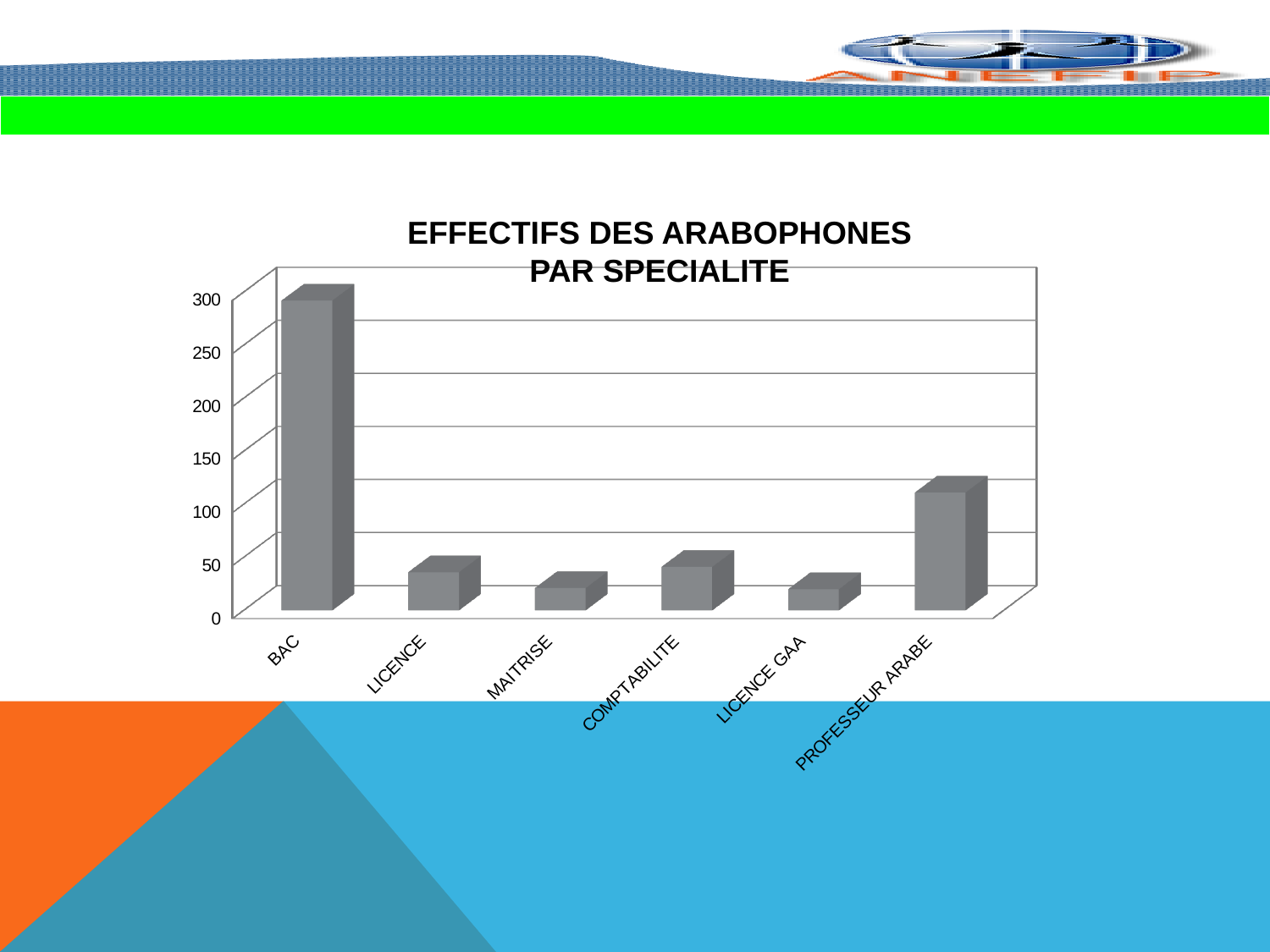
Is the value for BAC greater or less than 250? greater What is the title of the chart? EFFECTIFS DES ARABOPHONES PAR SPECIALITE Which has a larger value, PROFESSEUR ARABE or LICENCE? PROFESSEUR ARABE How many categories are shown on the x axis of the chart? 6 Is the value for PROFESSEUR ARABE greater or less than 50? greater What type of chart is shown on the slide? bar chart Is the value for PROFESSEUR ARABE greater or less than 150? less Which has a larger value, BAC or PROFESSEUR ARABE? BAC Which has a larger value, COMPTABILITE or MAITRISE? COMPTABILITE Which category has the highest value in the chart? BAC